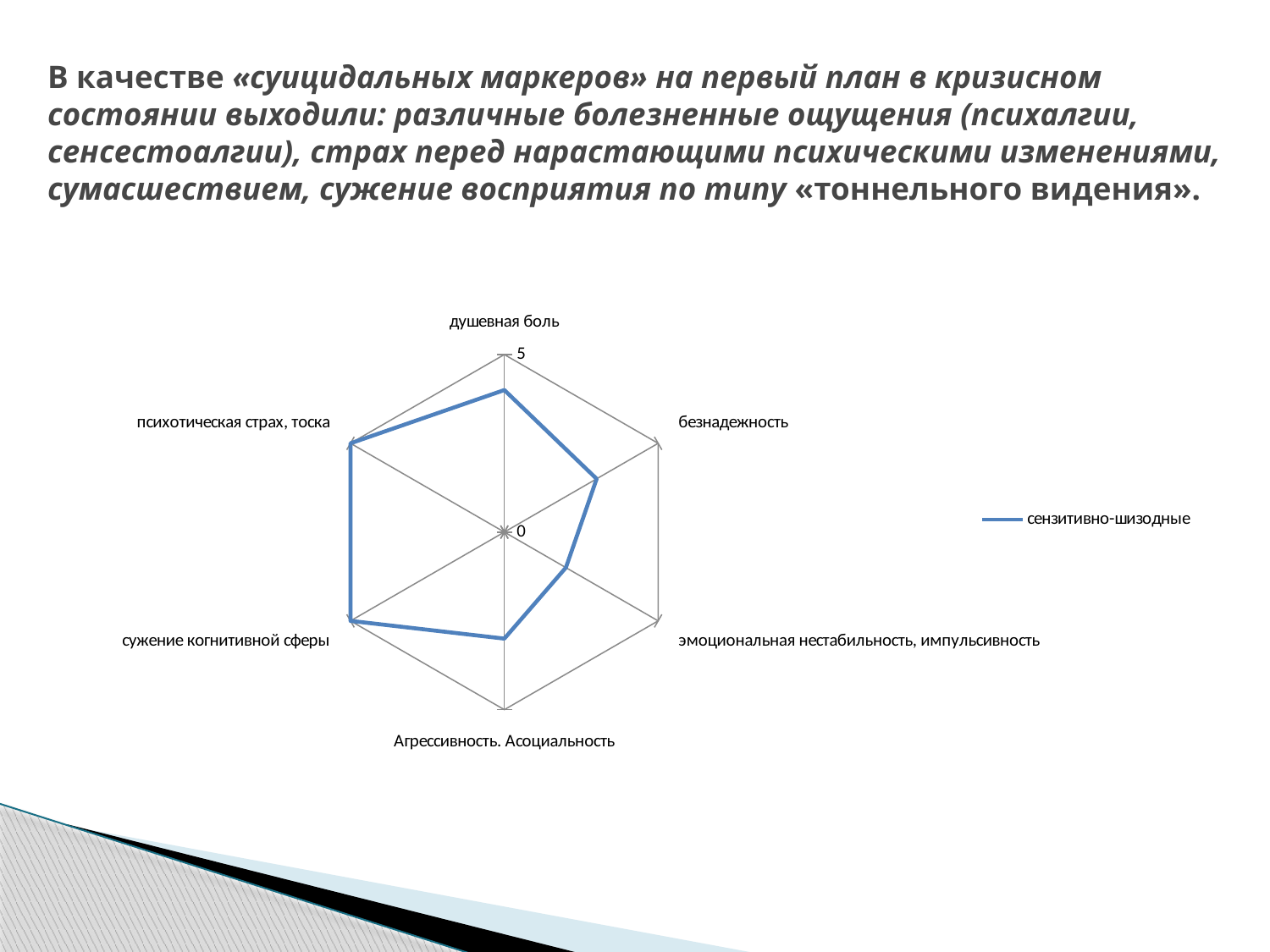
What kind of chart is shown on the slide? radar chart How many categories (axes) does the radar chart have? 6 Is the value for душевная боль greater or less than 5? less Which is larger: the value for сужение когнитивной сферы or the value for безнадежность? сужение когнитивной сферы Which is larger: the value for психотическая страх, тоска or the value for Агрессивность. Асоциальность? психотическая страх, тоска What is the name of the series shown in the legend? сензитивно-шизодные Is the value for безнадежность greater or less than 5? less Which category has the lowest value for the series сензитивно-шизодные? эмоциональная нестабильность, импульсивность Is the value for эмоциональная нестабильность, импульсивность greater or less than 5? less What is the maximum value shown on the radar chart's axis scale? 5 Which is larger: the value for душевная боль or the value for эмоциональная нестабильность, импульсивность? душевная боль How many series does the legend list? 1